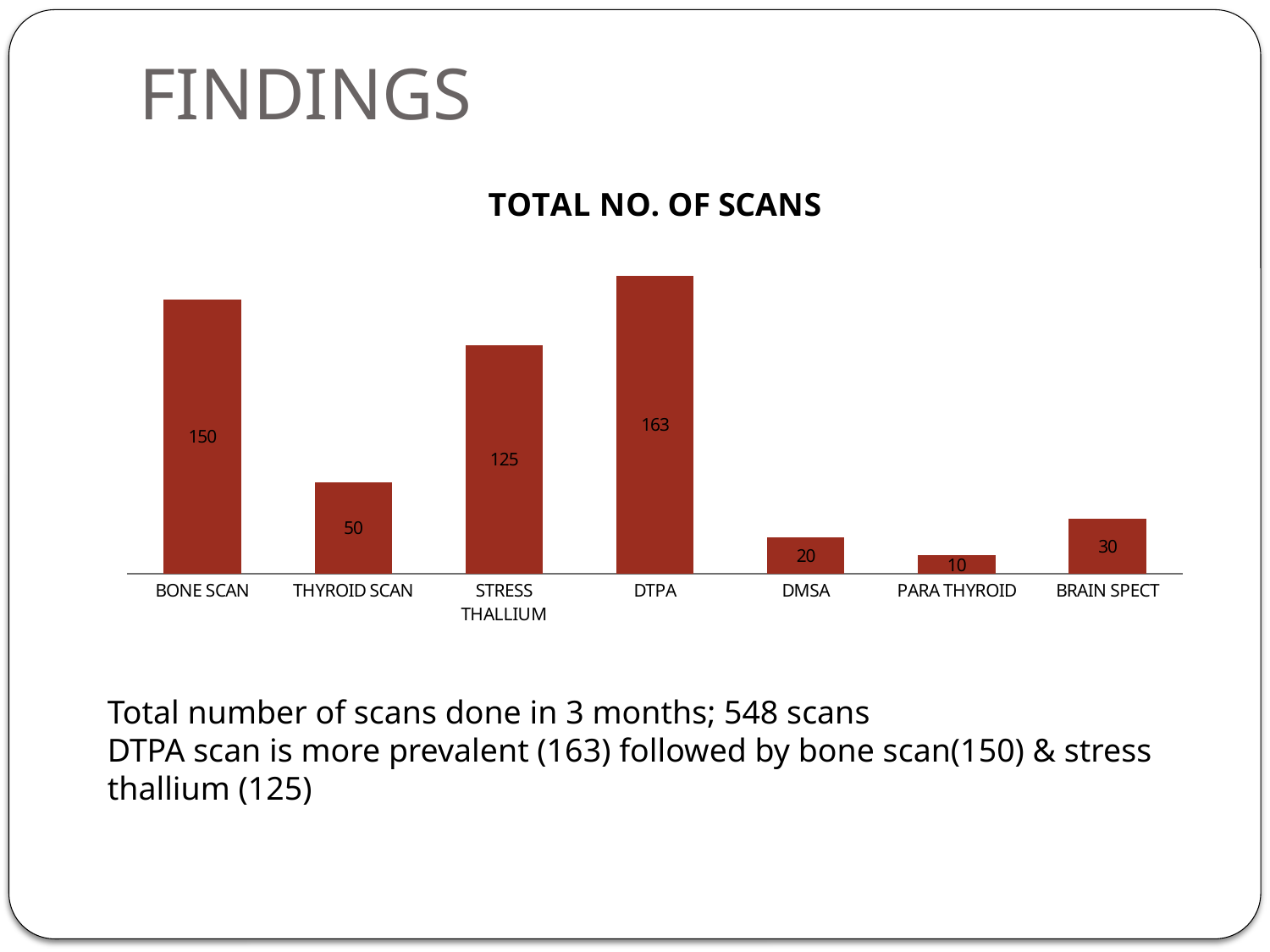
What is the difference between the values for THYROID SCAN and DMSA? 30 Which is larger, the value for BRAIN SPECT or the value for DMSA? BRAIN SPECT What is the value for DTPA? 163 How many categories are shown on the x axis? 7 What is the value for BRAIN SPECT? 30 What is the value for PARA THYROID? 10 What is the difference between the values for DTPA and BONE SCAN? 13 What is the title of the chart? TOTAL NO. OF SCANS Which category has the highest value? DTPA What kind of chart is shown on the slide? Bar chart Which category has the lowest value? PARA THYROID What is the value for STRESS THALLIUM? 125